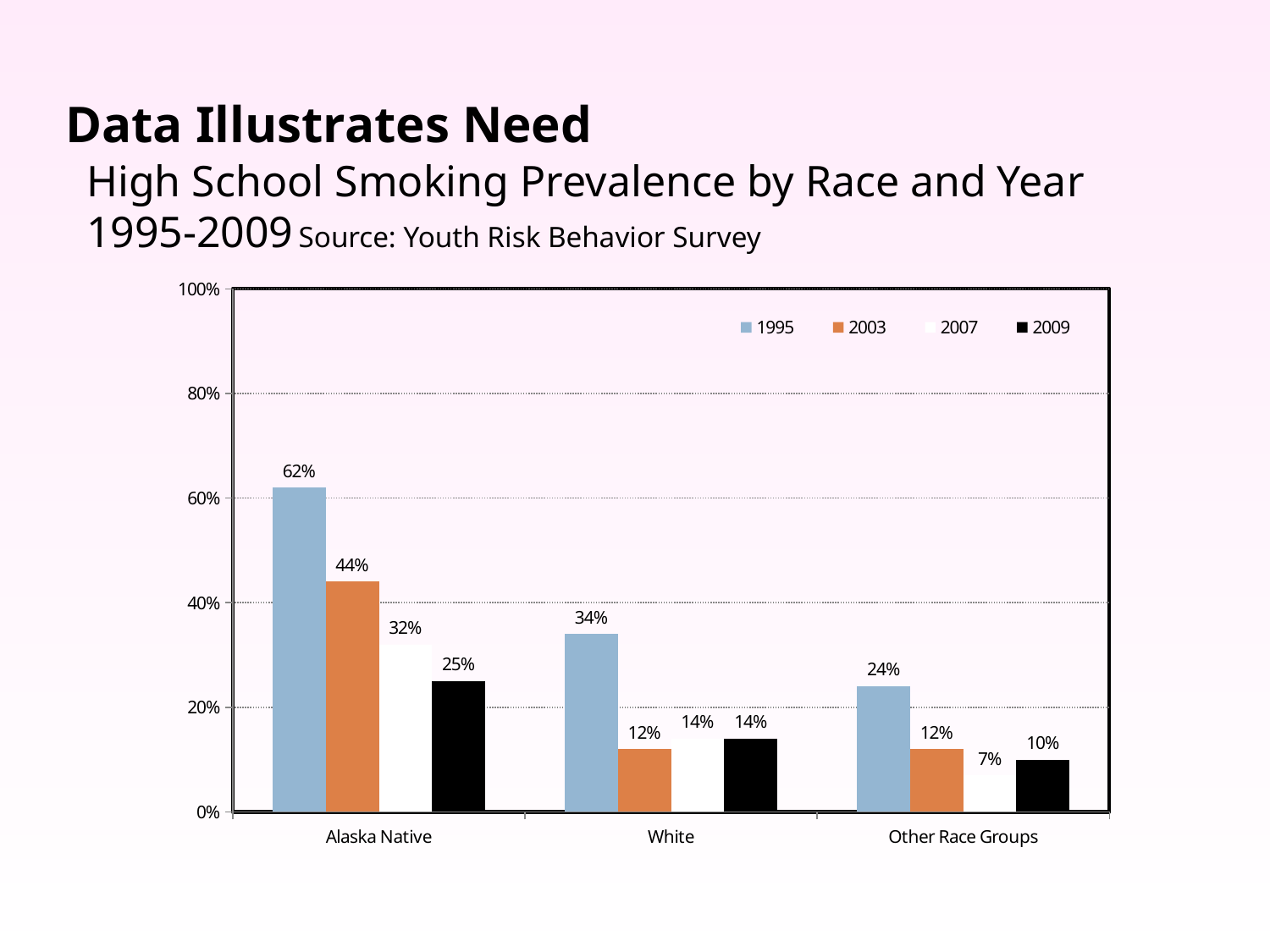
Which race group had the highest smoking prevalence in 2009? Alaska Native Which race group had the lowest smoking prevalence in 2007? Other Race Groups What kind of chart is shown on the slide? Bar chart How many years does the legend list? 4 What is the source of the data cited on the slide? Youth Risk Behavior Survey How many race groups are shown on the x axis? 3 What was the smoking prevalence for White high school students in 2003? 12% What is the difference between the 1995 and 2009 smoking prevalence for Alaska Native students? 37% Did the smoking prevalence for Alaska Native students rise or fall from 1995 to 2009? Fall What was the smoking prevalence for Alaska Native high school students in 1995? 62% Which is larger: the 2003 value for Alaska Native or the 1995 value for White? 2003 value for Alaska Native What was the smoking prevalence for Other Race Groups in 2007? 7%